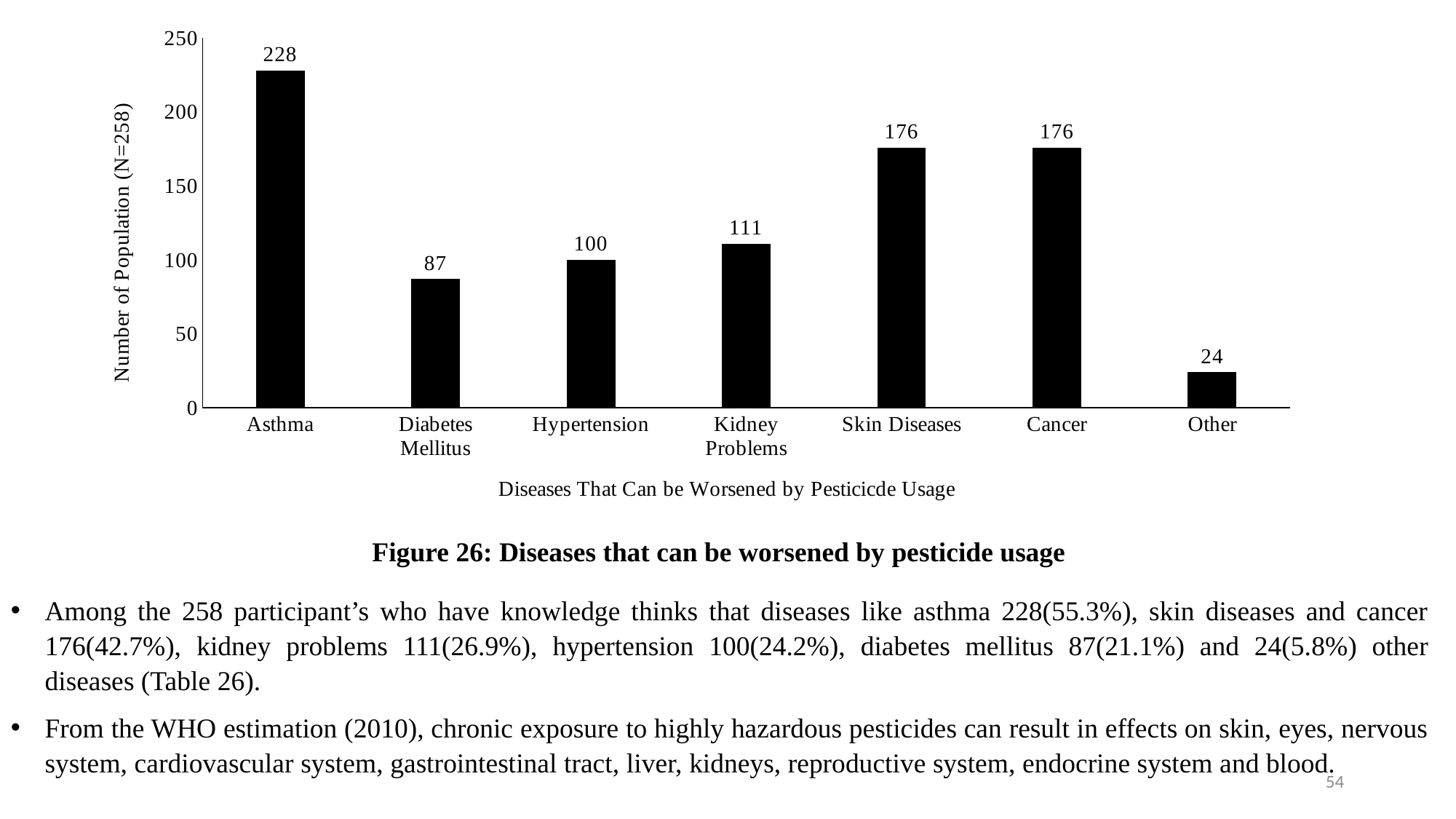
Which disease has the highest number of population? Asthma What is the difference between the values for Asthma and Cancer? 52 What is the value for Diabetes Mellitus? 87 What kind of chart is shown on the slide? bar chart Which is larger, the value for Kidney Problems or the value for Hypertension? Kidney Problems What is the difference between the values for Hypertension and Diabetes Mellitus? 13 Is the value for Skin Diseases greater or less than 150? greater What is the label of the y axis? Number of Population (N=258) What is the value for Asthma? 228 How many disease categories are shown on the x axis? 7 Which category has the lowest number of population? Other What is the value for Kidney Problems? 111